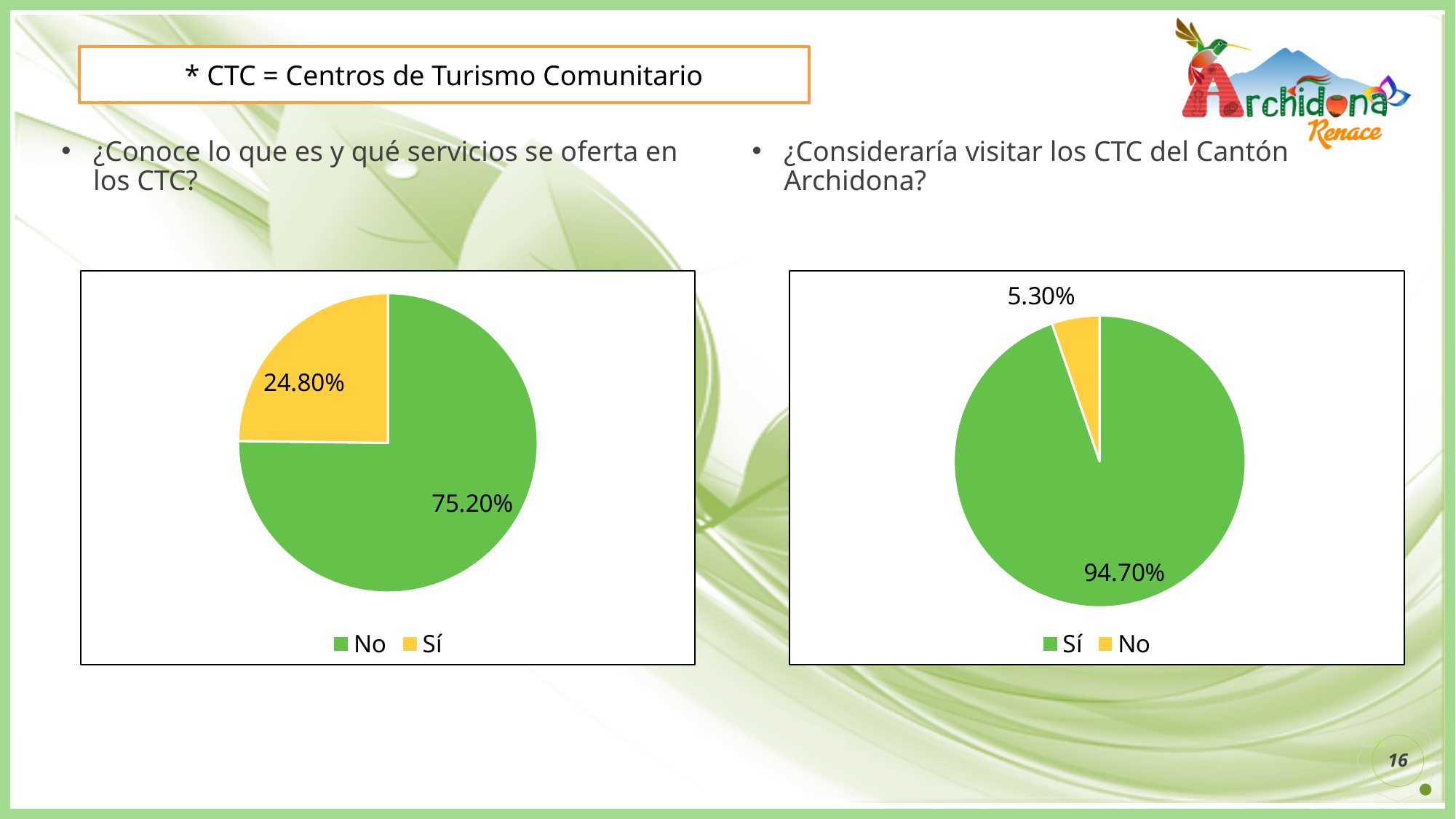
In the left pie chart (¿Conoce lo que es y qué servicios se oferta en los CTC?), what percentage is shown for No? 75.20% In the right pie chart (¿Consideraría visitar los CTC del Cantón Archidona?), what percentage is shown for No? 5.30% In the left pie chart, what is the difference between the No and Sí percentages? 50.40% In the right pie chart, what is the difference between the Sí and No percentages? 89.40% In the left pie chart (¿Conoce lo que es y qué servicios se oferta en los CTC?), what percentage is shown for Sí? 24.80% What type of chart is used on the left side of the slide? Pie chart In the left pie chart, what colour is the Sí slice? Yellow In the right pie chart, which category has the smallest slice? No In the right pie chart, which is larger, Sí or No? Sí In the left pie chart, which category has the largest slice? No In the right pie chart (¿Consideraría visitar los CTC del Cantón Archidona?), what percentage is shown for Sí? 94.70% How many categories does the legend of the right pie chart list? 2